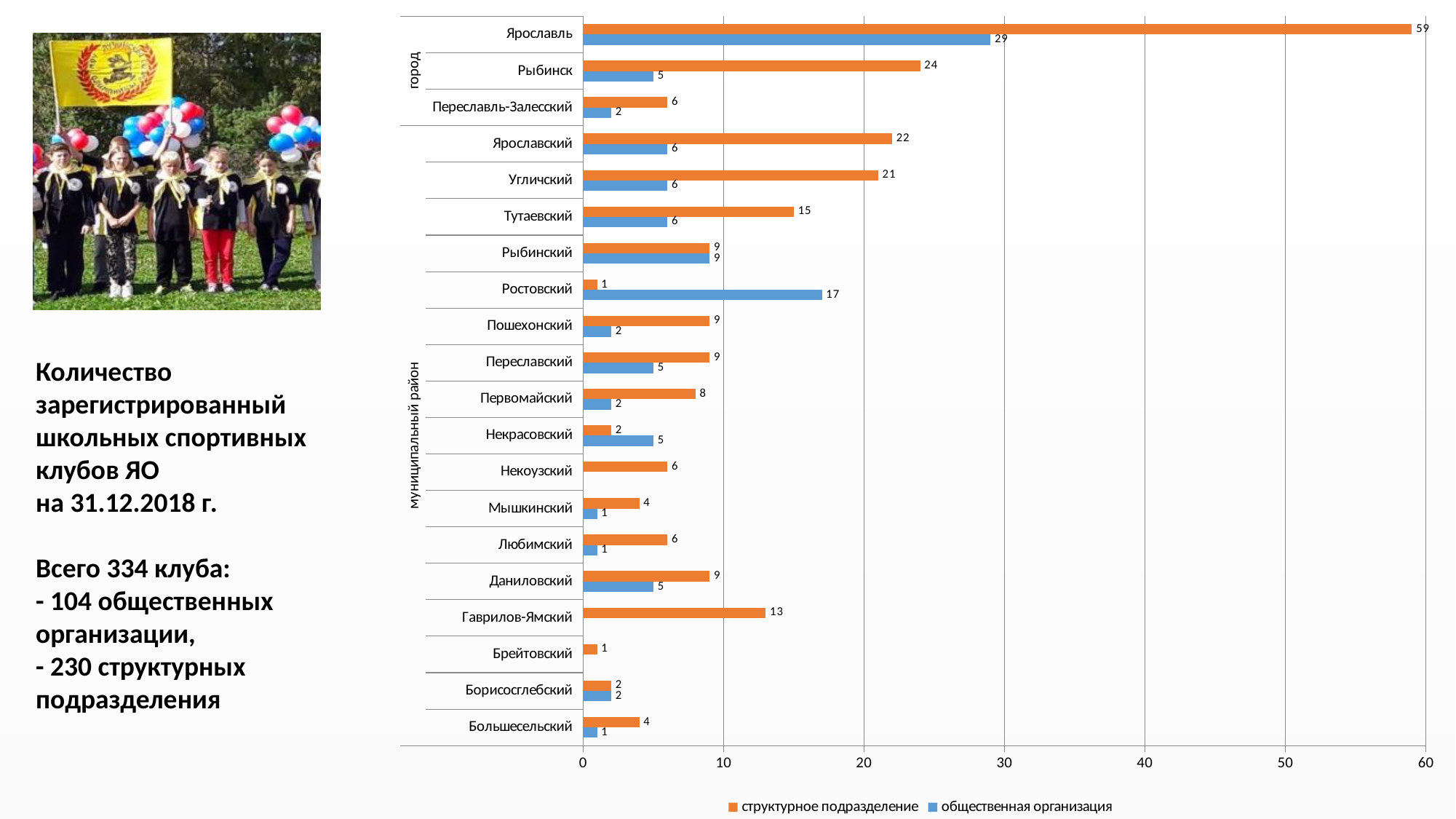
What is the difference between the структурное подразделение and общественная организация values for Рыбинск? 19 Which is larger for Угличский: структурное подразделение or общественная организация? структурное подразделение What kind of chart is shown on the slide? bar chart Which is larger for Ростовский: структурное подразделение or общественная организация? общественная организация How many categories are shown on the chart? 20 Which category has the highest value for структурное подразделение? Ярославль How many series does the legend list? 2 What is the value for структурное подразделение in Ярославль? 59 Which colour represents общественная организация in the chart? blue What is the value for общественная организация in Ростовский? 17 Which category has the highest value for общественная организация? Ярославль What is the value for структурное подразделение in Гаврилов-Ямский? 13